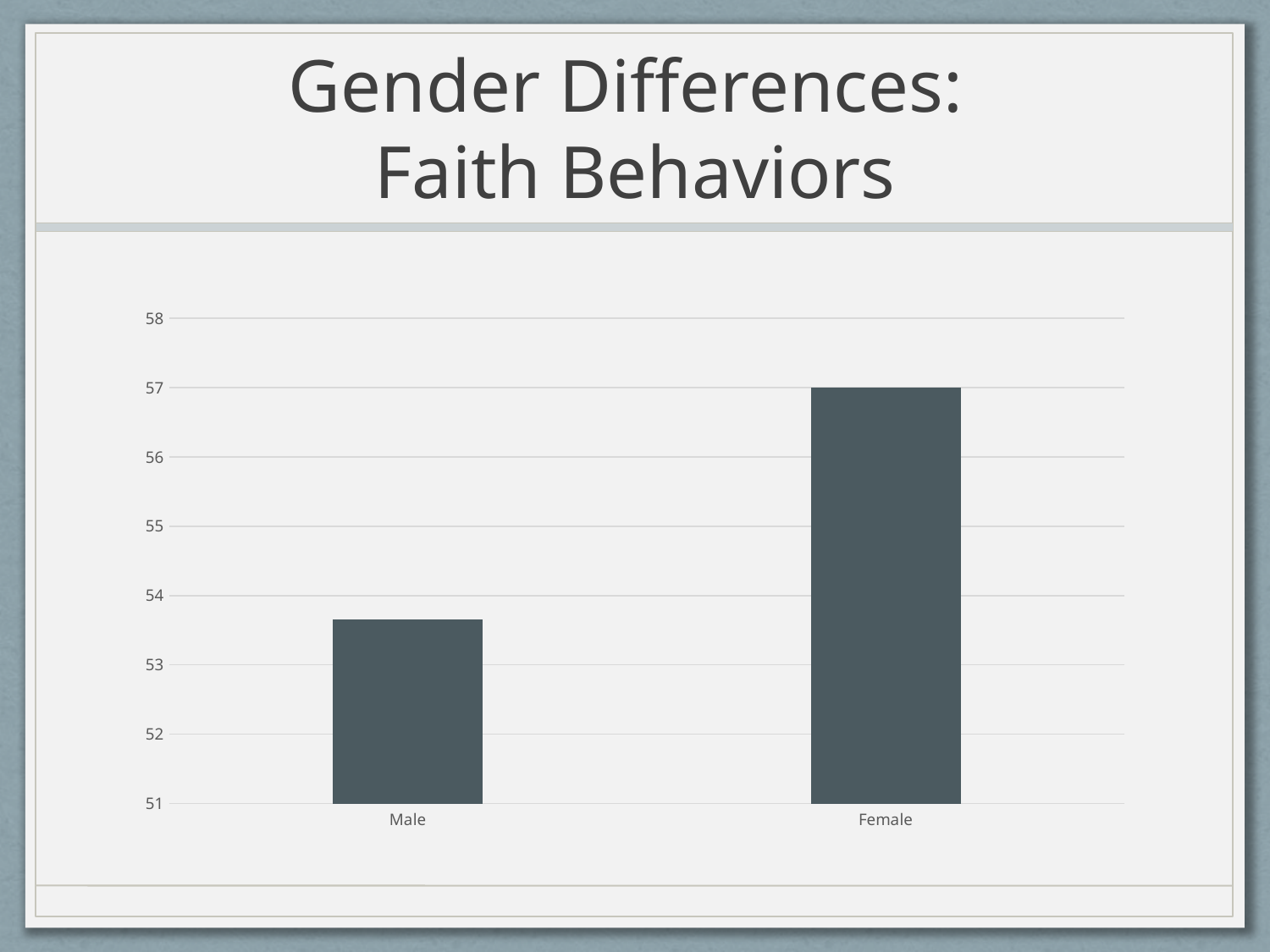
What kind of chart is shown on the slide? bar chart What is the title of the slide containing the chart? Gender Differences: Faith Behaviors How many categories are plotted in the chart? 2 What is the lowest value shown on the vertical axis? 51 Is the value for Male greater or less than 54? less Is the value for Female greater or less than 56? greater Which category has the highest value? Female Is the value for Male greater or less than 53? greater Which category has the lowest value? Male What is the value for Female? 57 Do the values rise or fall from Male to Female along the x axis? rise Which is larger, the value for Male or the value for Female? Female